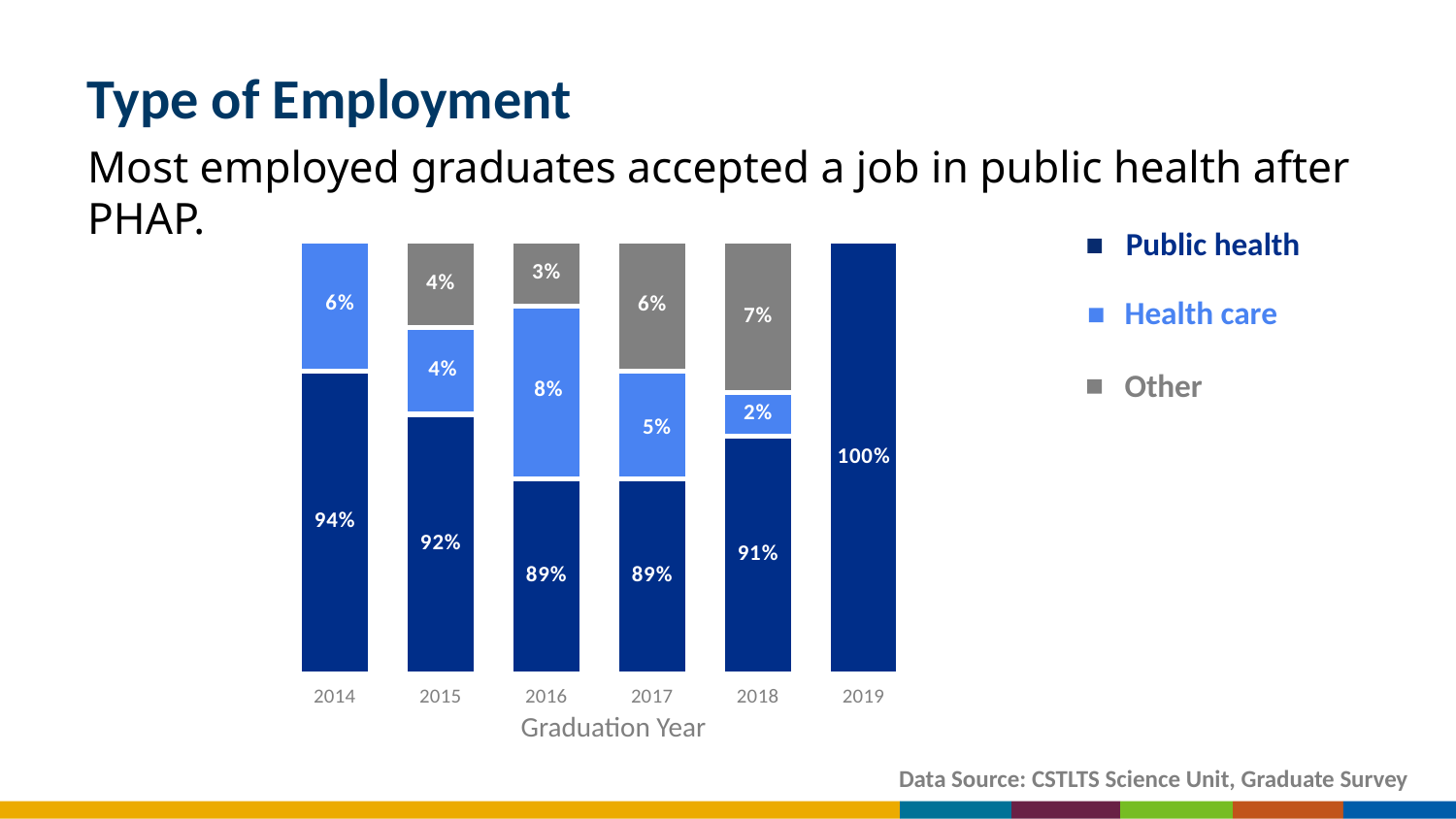
Which is larger, the Other value for 2017 or the Other value for 2015? 2017 Which graduation year has the lowest Health care percentage among years where it is shown? 2018 How many graduation years are shown on the x axis? 6 How many series does the legend list? 3 What is the Health care value for the 2016 graduation year? 8% What is the difference between the Public health percentages for 2014 and 2016? 5% What is the total of the Public health and Health care segments for 2015? 96% What percentage of employed graduates from 2014 took a job in public health? 94% What kind of chart is shown on the slide? Stacked bar chart What is the Other value for the 2018 graduation year? 7% Which graduation year has the highest Public health percentage? 2019 What is the label of the x axis? Graduation Year